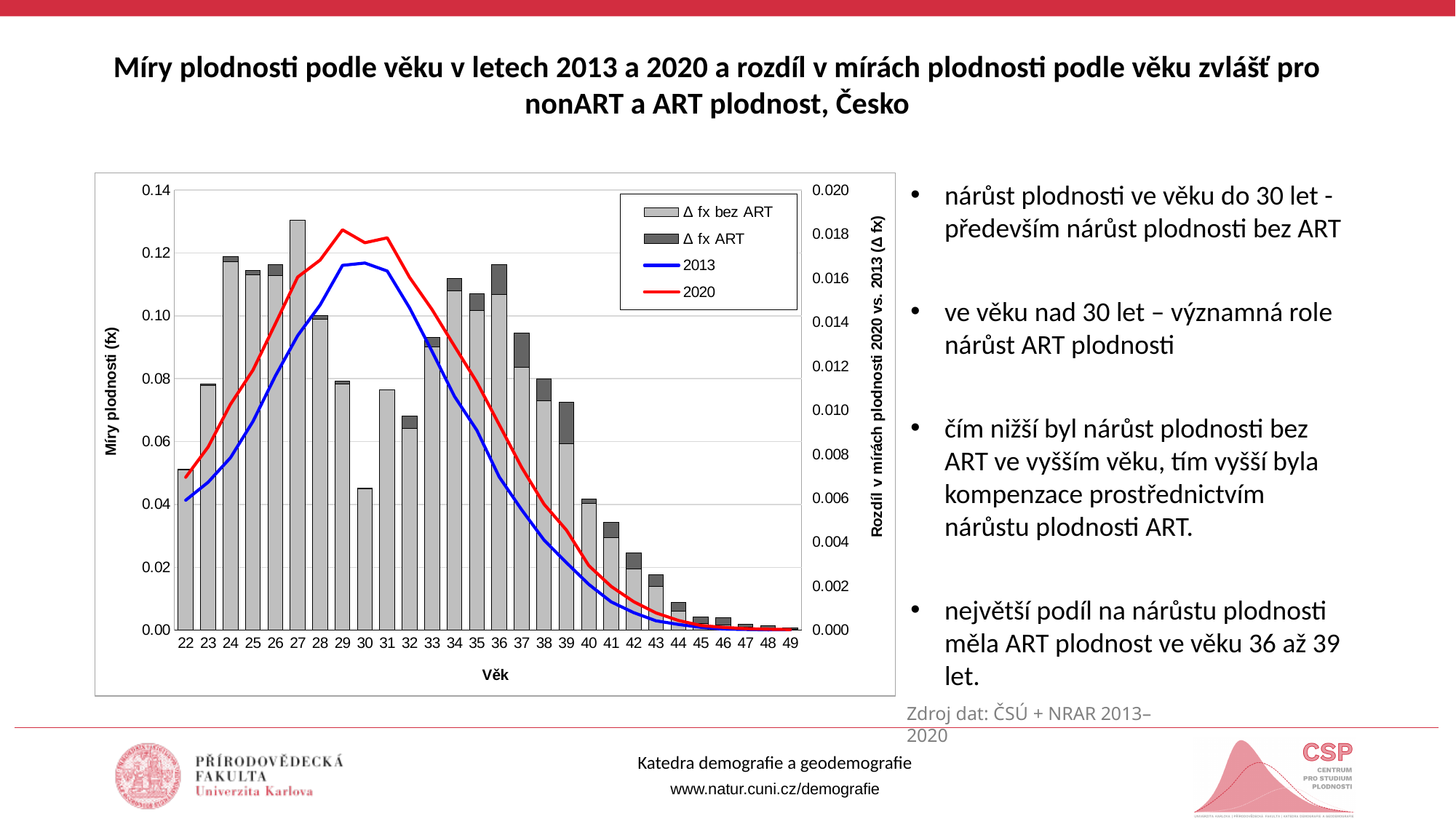
At age 25, which line is higher, 2013 or 2020? 2020 What is the title of the x axis of the chart? Věk At which age does the blue 2013 line reach its highest value? 30 Does the 2013 line rise or fall from age 30 to age 49? It falls Is the value of the 2020 line at age 29 greater or less than 0.12 on the left axis? greater How many series does the chart legend list? 4 How many age categories are shown on the x axis of the chart? 28 What kind of chart is shown on the slide? A combined bar and line chart Is the total stacked bar at age 30 greater or less than 0.008 on the right axis? less At which age does the red 2020 line reach its highest value? 29 Is the value of the 2013 line at age 30 greater or less than 0.10 on the left axis? greater At which age does the stacked bar (Δ fx bez ART plus Δ fx ART) reach its highest value? 27